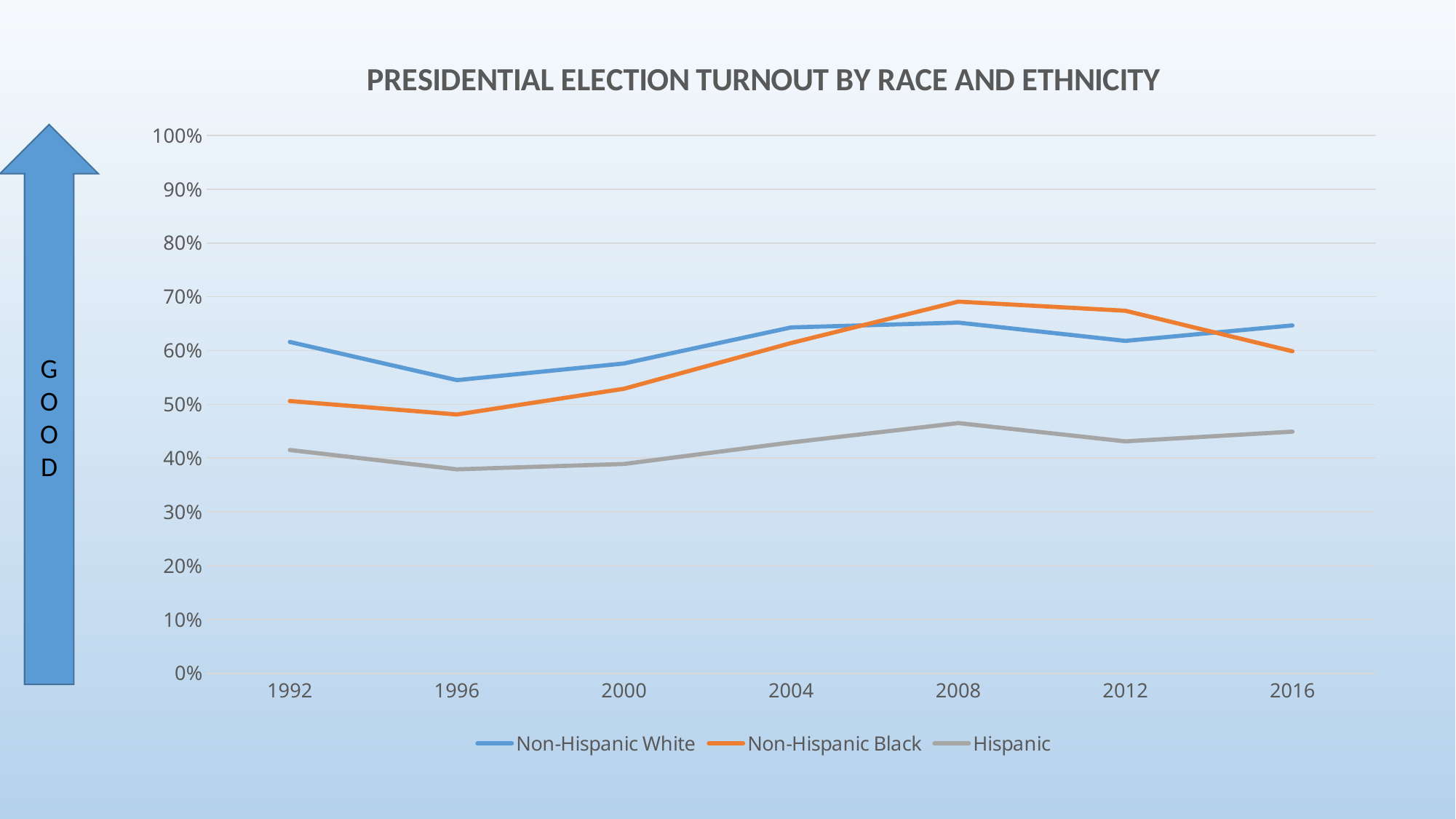
How many election years are plotted along the x axis? 7 In 2016, which is larger: Non-Hispanic White turnout or Non-Hispanic Black turnout? Non-Hispanic White Is the Non-Hispanic Black turnout in 2008 greater or less than 60%? greater What is the title of the chart? PRESIDENTIAL ELECTION TURNOUT BY RACE AND ETHNICITY In which year does the Non-Hispanic Black series reach its highest value? 2008 Does the Hispanic turnout rise or fall from 1992 to 1996? Fall Which series has the lowest turnout in every year shown? Hispanic In which year does the Non-Hispanic Black series reach its lowest value? 1996 How many series does the legend list? 3 What kind of chart is shown on the slide? Line chart Is the Hispanic turnout in 1996 greater or less than 40%? less Which series has the highest turnout in 2008? Non-Hispanic Black